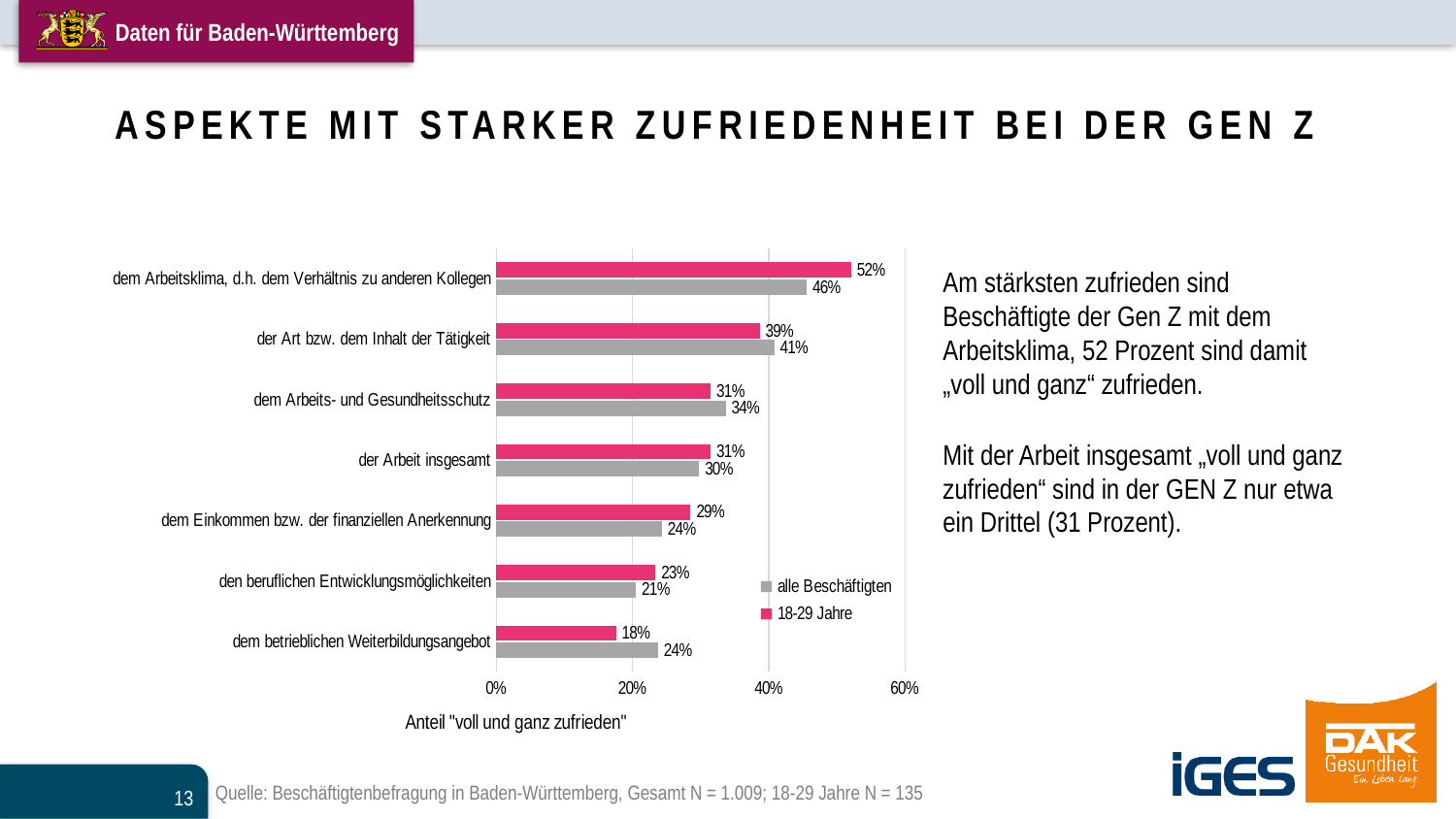
How many series does the legend list? 2 Is the "alle Beschäftigten" value for "dem Arbeitsklima, d.h. dem Verhältnis zu anderen Kollegen" greater or less than 40%? greater What is the difference between the "18-29 Jahre" and "alle Beschäftigten" values for "dem Arbeitsklima, d.h. dem Verhältnis zu anderen Kollegen"? 6% What kind of chart is shown on the slide? bar chart What is the value for "alle Beschäftigten" for "der Art bzw. dem Inhalt der Tätigkeit"? 41% What is the value for "18-29 Jahre" for "dem Arbeitsklima, d.h. dem Verhältnis zu anderen Kollegen"? 52% What is the label of the horizontal axis of the chart? Anteil "voll und ganz zufrieden" For "dem Einkommen bzw. der finanziellen Anerkennung", which series has the larger value, "18-29 Jahre" or "alle Beschäftigten"? 18-29 Jahre Which category has the highest value for "18-29 Jahre"? dem Arbeitsklima, d.h. dem Verhältnis zu anderen Kollegen What is the value for "18-29 Jahre" for "dem betrieblichen Weiterbildungsangebot"? 18% How many categories are shown on the chart? 7 Which category has the lowest value for "18-29 Jahre"? dem betrieblichen Weiterbildungsangebot